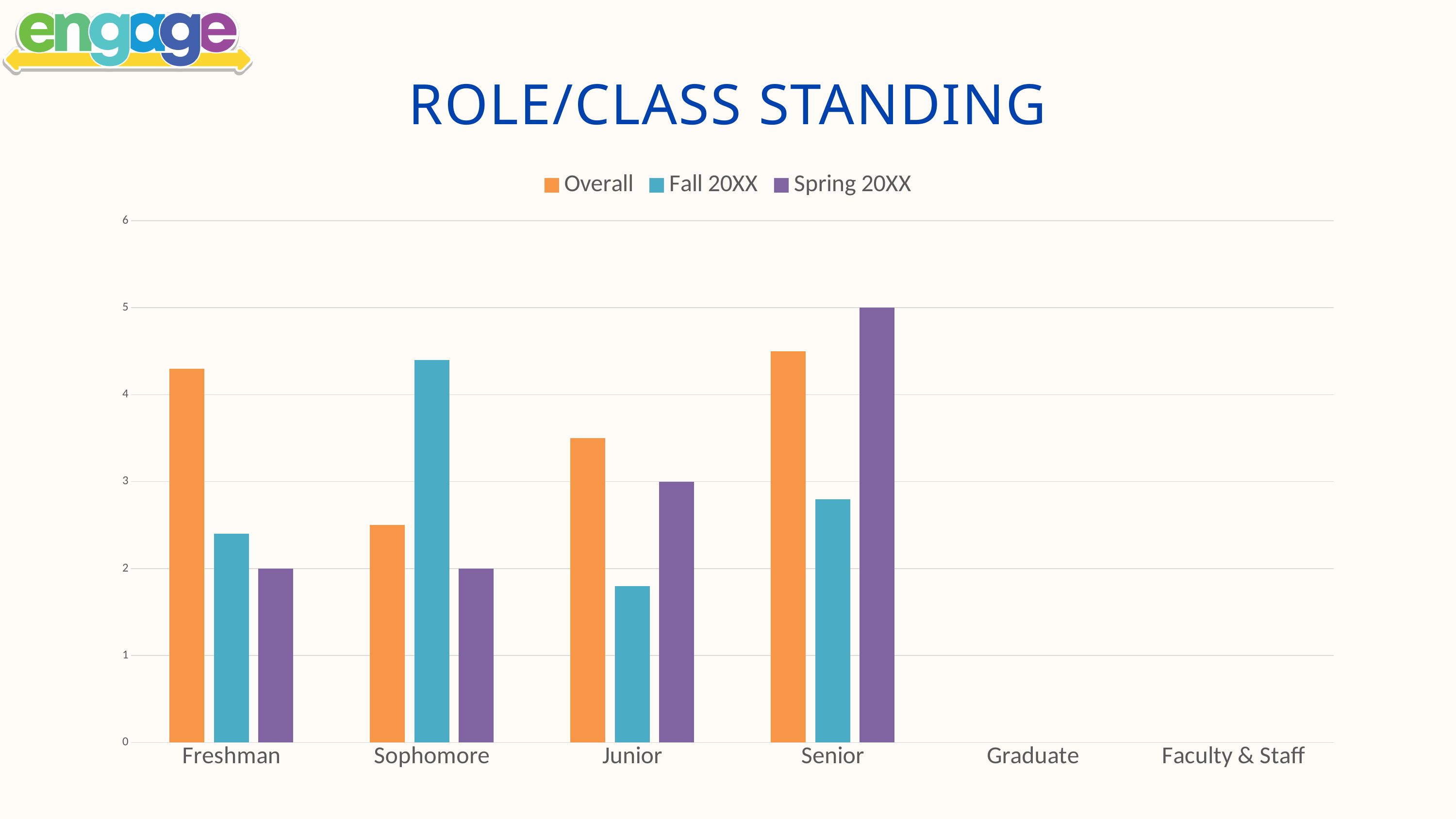
Which is larger for Sophomore, the Overall value or the Fall 20XX value? Fall 20XX What kind of chart is shown on the slide? bar chart Which category has the lowest Fall 20XX value among those with bars? Junior What is the Spring 20XX value for Junior? 3 Which category has the highest Spring 20XX value? Senior What is the Spring 20XX value for Senior? 5 How many categories are shown on the x axis? 6 How many series does the legend list? 3 What is the title of the chart? ROLE/CLASS STANDING What is the Spring 20XX value for Freshman? 2 Is the Fall 20XX value for Junior greater or less than 2? less Is the Overall value for Freshman greater or less than 4? greater